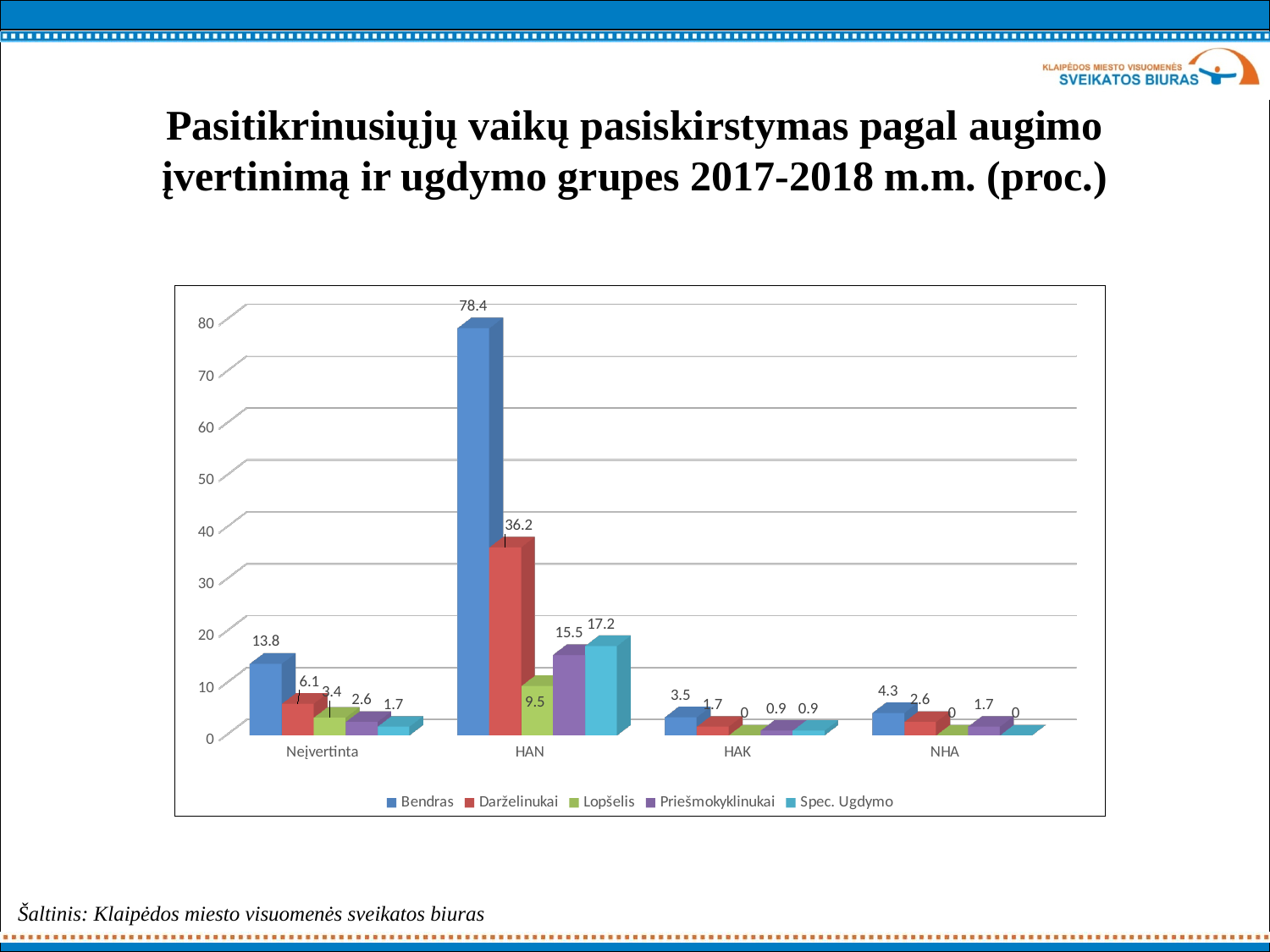
What is the value for Spec. Ugdymo in the Neįvertinta category? 1.7 Which series is shown in red in the legend? Darželinukai What is the difference between the Bendras and Darželinukai values in the HAN category? 42.2 How many categories are shown on the x axis? 4 What kind of chart is shown on the slide? bar chart How many series does the legend list? 5 What is the value for Bendras in the HAN category? 78.4 What is the value for Lopšelis in the HAK category? 0 What is the value for Darželinukai in the HAN category? 36.2 Which is larger in the HAN category, Priešmokyklinukai or Spec. Ugdymo? Spec. Ugdymo Which series has the lowest value in the HAN category? Lopšelis Which category has the highest value for Bendras? HAN